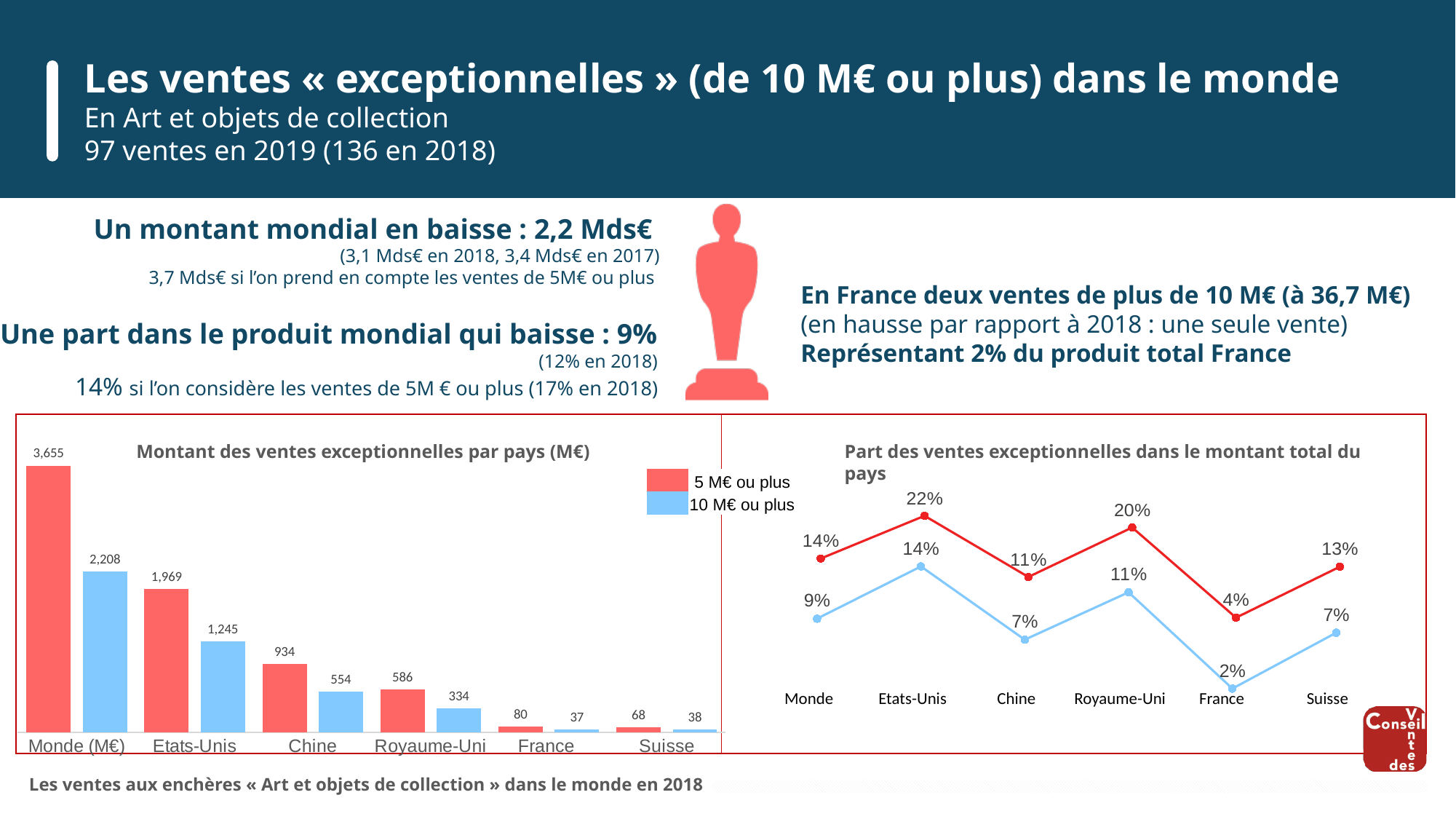
In the chart 'Montant des ventes exceptionnelles par pays (M€)', what is the value for Etats-Unis in the '5 M€ ou plus' series? 1,969 In the chart 'Montant des ventes exceptionnelles par pays (M€)', which category has the lowest value in the '10 M€ ou plus' series? France In the chart 'Montant des ventes exceptionnelles par pays (M€)', what is the value for Chine in the '10 M€ ou plus' series? 554 In the chart 'Part des ventes exceptionnelles dans le montant total du pays', which category has the highest value on the red line? Etats-Unis What kind of chart is 'Part des ventes exceptionnelles dans le montant total du pays'? Line chart In the chart 'Part des ventes exceptionnelles dans le montant total du pays', what is the value of the blue line for France? 2% In the chart 'Montant des ventes exceptionnelles par pays (M€)', what is the difference between the '5 M€ ou plus' and '10 M€ ou plus' values for Monde? 1,447 In the chart 'Montant des ventes exceptionnelles par pays (M€)', which is larger: the '5 M€ ou plus' value for Royaume-Uni or the '10 M€ ou plus' value for Chine? Royaume-Uni (5 M€ ou plus) In the chart 'Part des ventes exceptionnelles dans le montant total du pays', what is the value of the red line for Royaume-Uni? 20% What kind of chart is 'Montant des ventes exceptionnelles par pays (M€)'? Bar chart In the chart 'Part des ventes exceptionnelles dans le montant total du pays', how many categories are shown on the x axis? 6 In the chart 'Montant des ventes exceptionnelles par pays (M€)', how many series does the legend list? 2